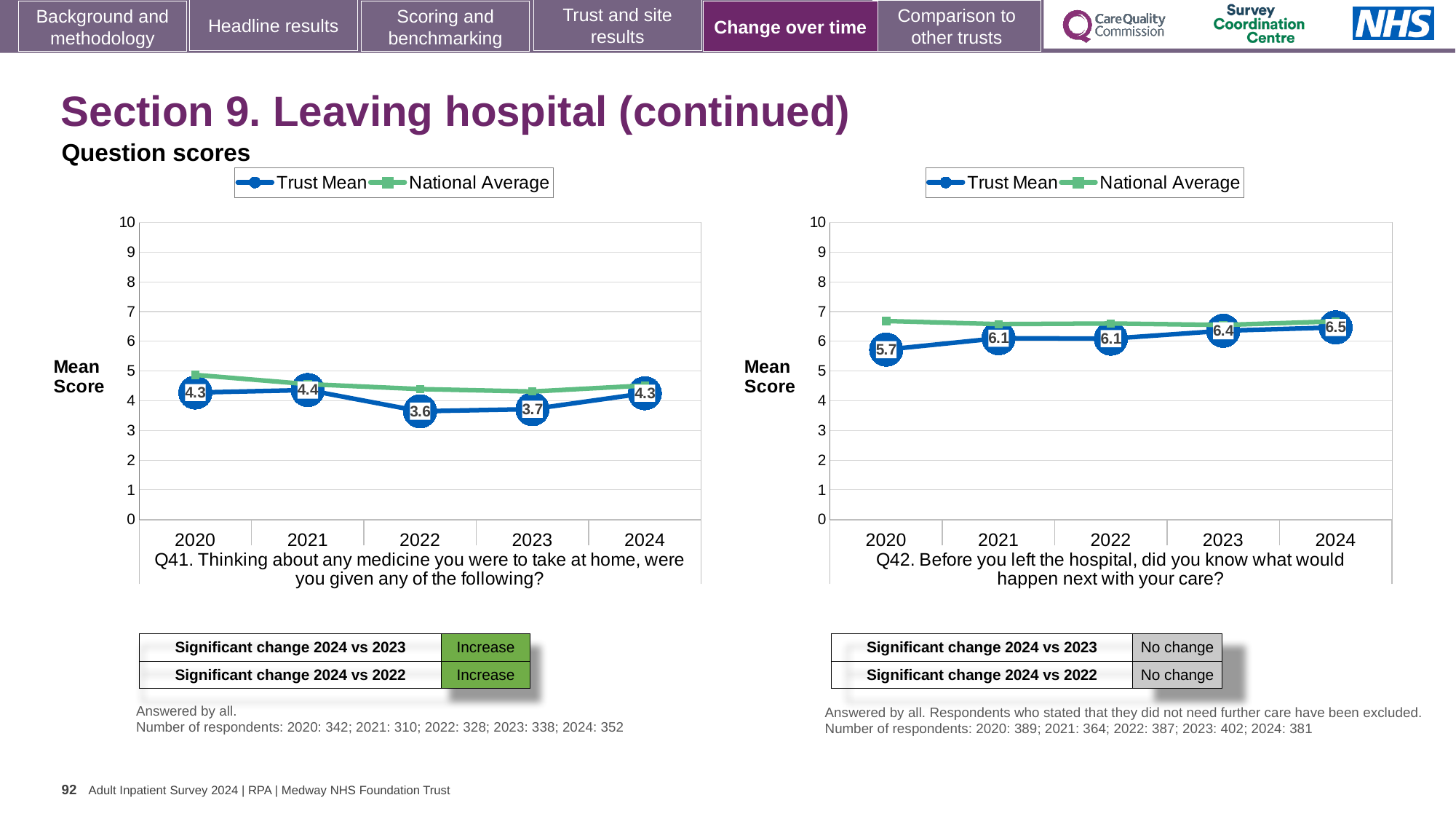
In the Q42 chart, is the National Average for 2020 greater or less than 6? greater In the Q41 chart, which year has the lowest Trust Mean score? 2022 In the Q42 chart, what is the Trust Mean score for 2023? 6.4 In the Q41 chart, what is the Trust Mean score for 2022? 3.6 In the Q42 chart, which year has the highest Trust Mean score? 2024 How many series does the legend of the Q42 chart list? 2 In the Q41 chart, is the Trust Mean score for 2023 greater or less than 4? less In the Q41 chart, what is the Trust Mean score for 2024? 4.3 In the Q42 chart, what is the difference between the Trust Mean scores for 2024 and 2020? 0.8 What kind of chart is the Q41 chart? Line chart In the Q42 chart, what is the Trust Mean score for 2020? 5.7 In the Q41 chart, what is the difference between the Trust Mean scores for 2021 and 2022? 0.8